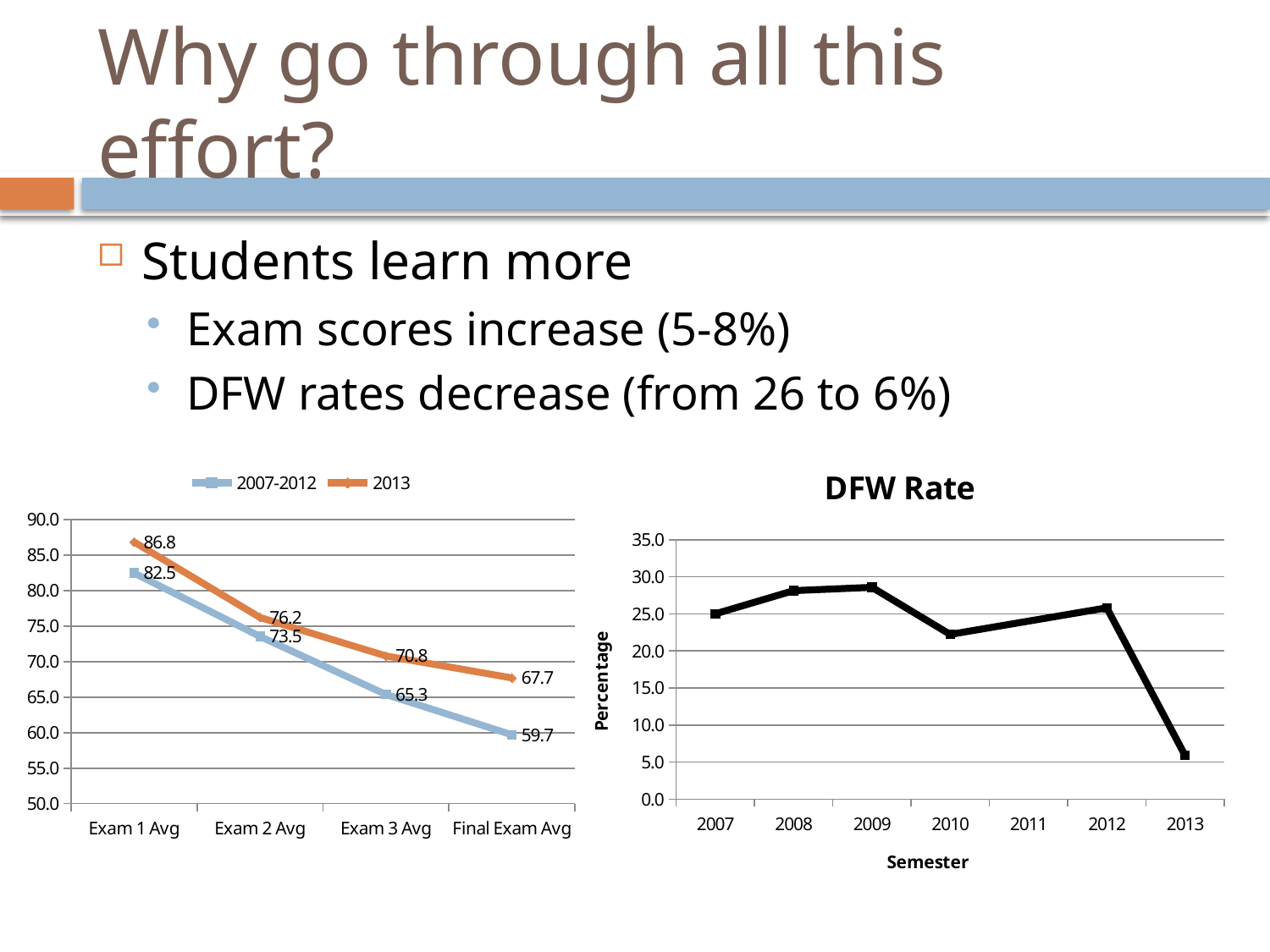
In the left chart, what is the 2013 value for Exam 1 Avg? 86.8 In the DFW Rate chart, which semester has the lowest DFW rate? 2013 What kind of chart is the DFW Rate chart? line chart In the left chart, which is larger for Exam 2 Avg: the 2007-2012 value or the 2013 value? 2013 How many series does the legend of the left chart list? 2 In the DFW Rate chart, is the value for 2013 greater or less than 10.0? less In the left chart, which exam has the lowest 2007-2012 average? Final Exam Avg In the left chart, do the 2013 values rise or fall from Exam 1 Avg to Final Exam Avg? fall In the DFW Rate chart, how many semesters are shown on the x axis? 7 In the left chart, what is the 2013 value for Exam 3 Avg? 70.8 In the left chart, what is the difference between the 2013 and 2007-2012 values for Final Exam Avg? 8.0 In the left chart, what is the 2007-2012 value for Final Exam Avg? 59.7